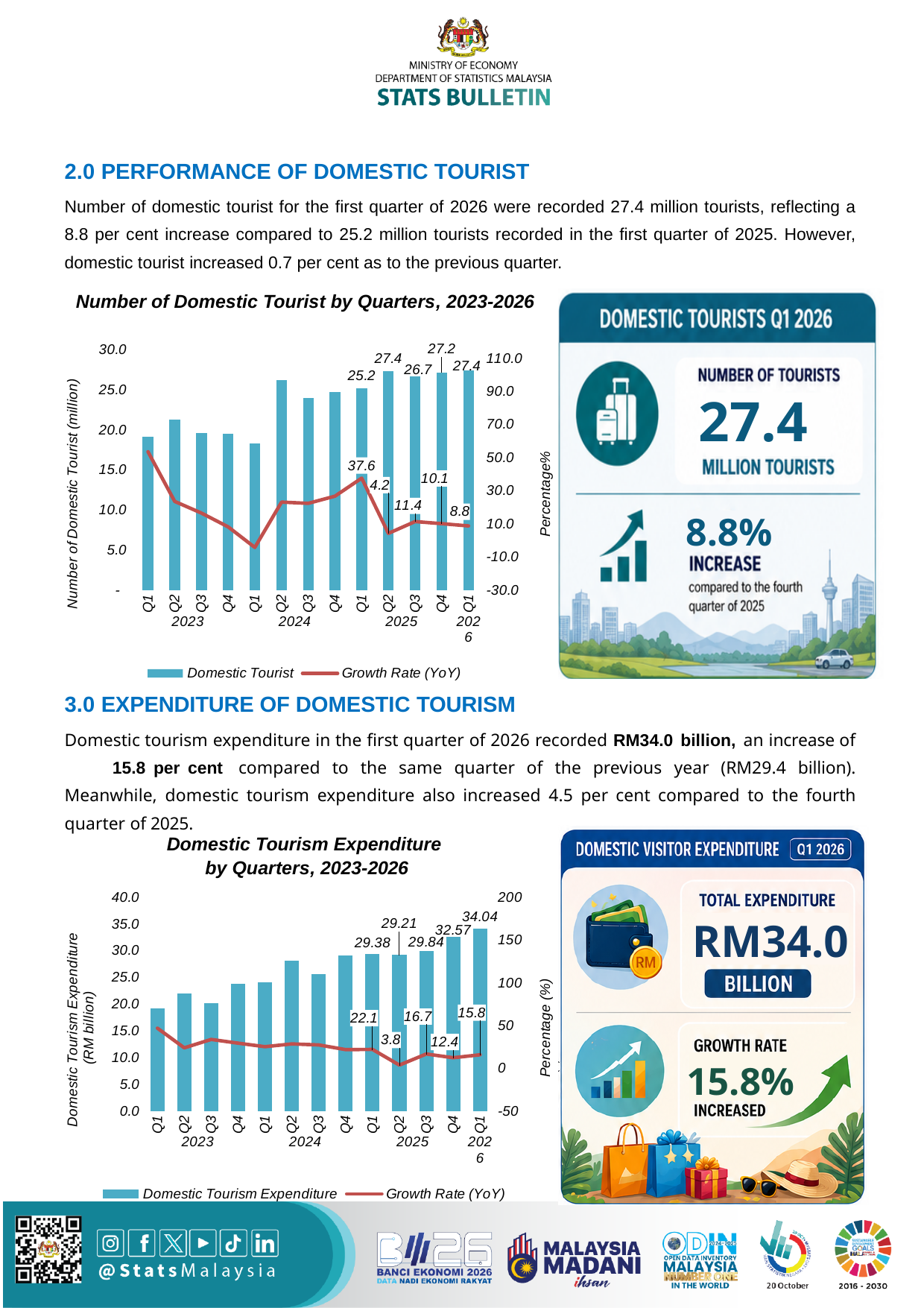
In the 'Number of Domestic Tourist by Quarters, 2023-2026' chart, what is the number of domestic tourists for Q1 2026? 27.4 How many series does the legend of the 'Number of Domestic Tourist by Quarters, 2023-2026' chart list? 2 In the 'Number of Domestic Tourist by Quarters, 2023-2026' chart, what is the difference between the Q4 2025 and Q3 2025 domestic tourist values? 0.5 In the 'Domestic Tourism Expenditure by Quarters, 2023-2026' chart, which quarter has the highest domestic tourism expenditure? Q1 2026 In the 'Domestic Tourism Expenditure by Quarters, 2023-2026' chart, what is the difference between the Q1 2026 and Q4 2025 expenditure values? 1.47 In the 'Number of Domestic Tourist by Quarters, 2023-2026' chart, which quarter has a higher growth rate (YoY): Q3 2025 or Q4 2025? Q3 2025 In the 'Domestic Tourism Expenditure by Quarters, 2023-2026' chart, what is the growth rate (YoY) for Q2 2025? 3.8 In the 'Number of Domestic Tourist by Quarters, 2023-2026' chart, which quarter has the lowest growth rate (YoY)? Q1 2024 In the 'Number of Domestic Tourist by Quarters, 2023-2026' chart, what is the growth rate (YoY) for Q1 2025? 37.6 How many quarters are plotted in the 'Number of Domestic Tourist by Quarters, 2023-2026' chart? 13 In the 'Number of Domestic Tourist by Quarters, 2023-2026' chart, is the domestic tourist value for Q2 2024 greater or less than 25.0? greater In the 'Domestic Tourism Expenditure by Quarters, 2023-2026' chart, what is the expenditure for Q1 2026? 34.04